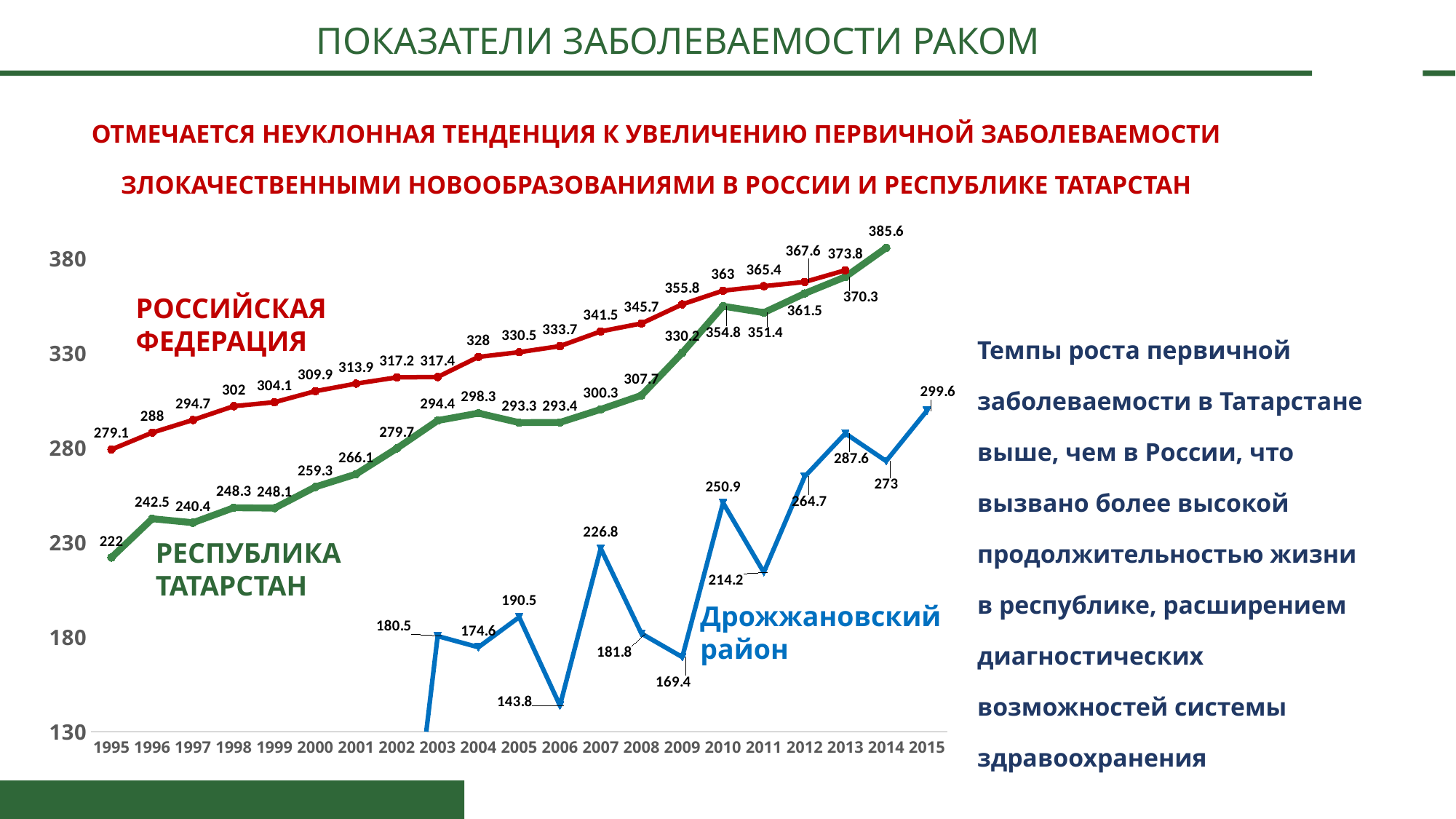
What is the value for Республика Татарстан in 2014? 385.6 What is the value for Российская Федерация in 1995? 279.1 What type of chart is shown on the slide? Line chart What is the value for Дрожжановский район in 2010? 250.9 What is the difference between the Российская Федерация value and the Республика Татарстан value in 2013? 3.5 In which year does the Республика Татарстан series reach its highest value? 2014 What is the value for Российская Федерация in 2005? 330.5 Does the Российская Федерация series rise or fall from 1995 to 2013? Rises Is the value for Республика Татарстан in 1995 greater or less than 230? less In which year does the Дрожжановский район series reach its lowest value? 2006 How many years are shown on the x axis? 21 Which is larger in 2010: the value for Российская Федерация or for Республика Татарстан? Российская Федерация